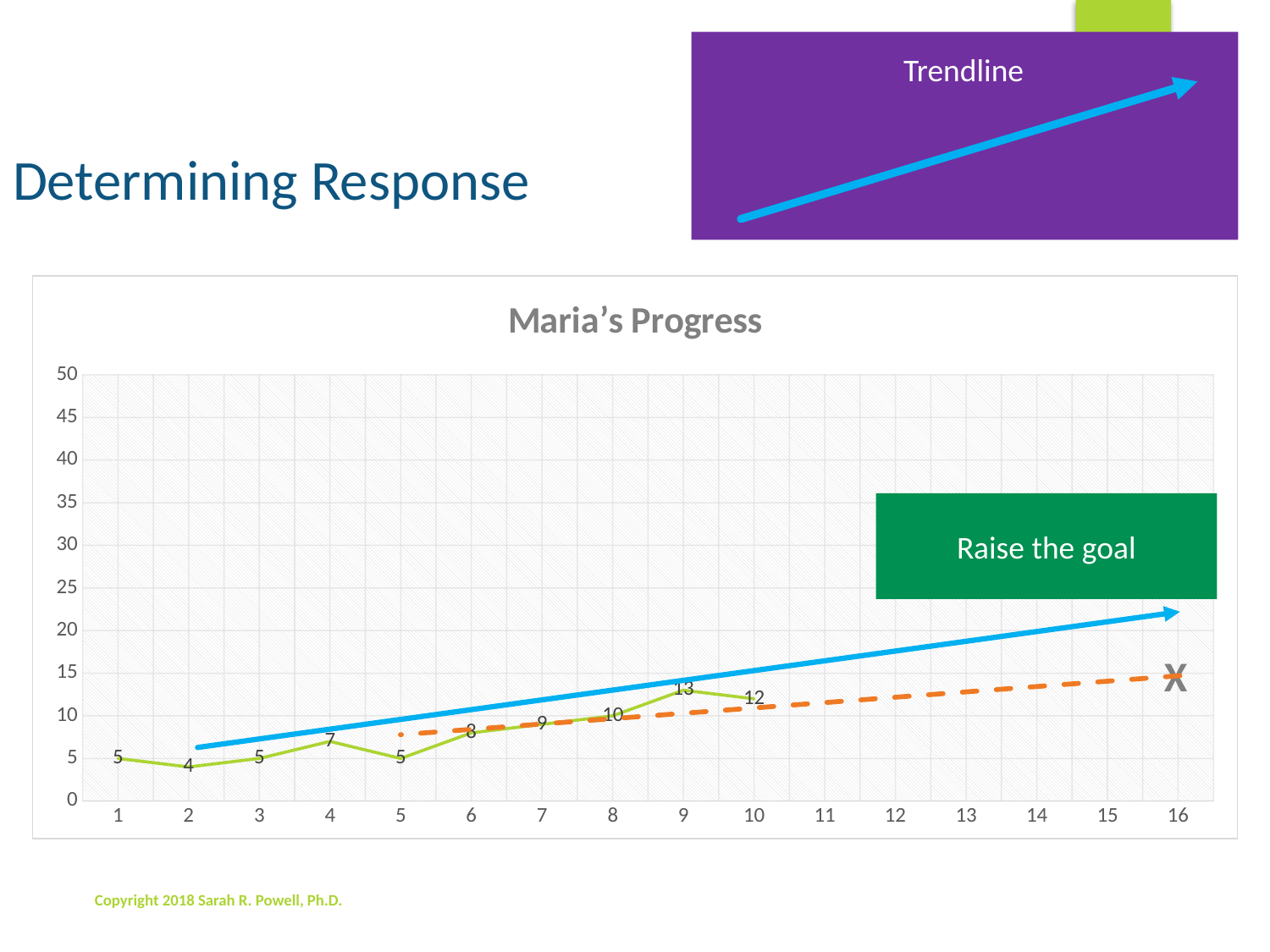
Which is larger in Maria's Progress, the value at point 4 or the value at point 5? point 4 What is the value plotted at point 9 in Maria's Progress? 13 At which point does Maria's Progress reach its highest value? 9 Is the value at point 9 in Maria's Progress greater or less than 10? greater How many data points are plotted with labels on the green line in Maria's Progress? 10 What is the title of the chart? Maria's Progress What is the value plotted at point 2 in Maria's Progress? 4 What is the value plotted at point 6 in Maria's Progress? 8 What type of chart is shown on the slide? line chart Do the values on the green line in Maria's Progress generally rise or fall from point 1 to point 10? rise What is the difference between the values at point 10 and point 1 in Maria's Progress? 7 At which point does Maria's Progress have its lowest value? 2